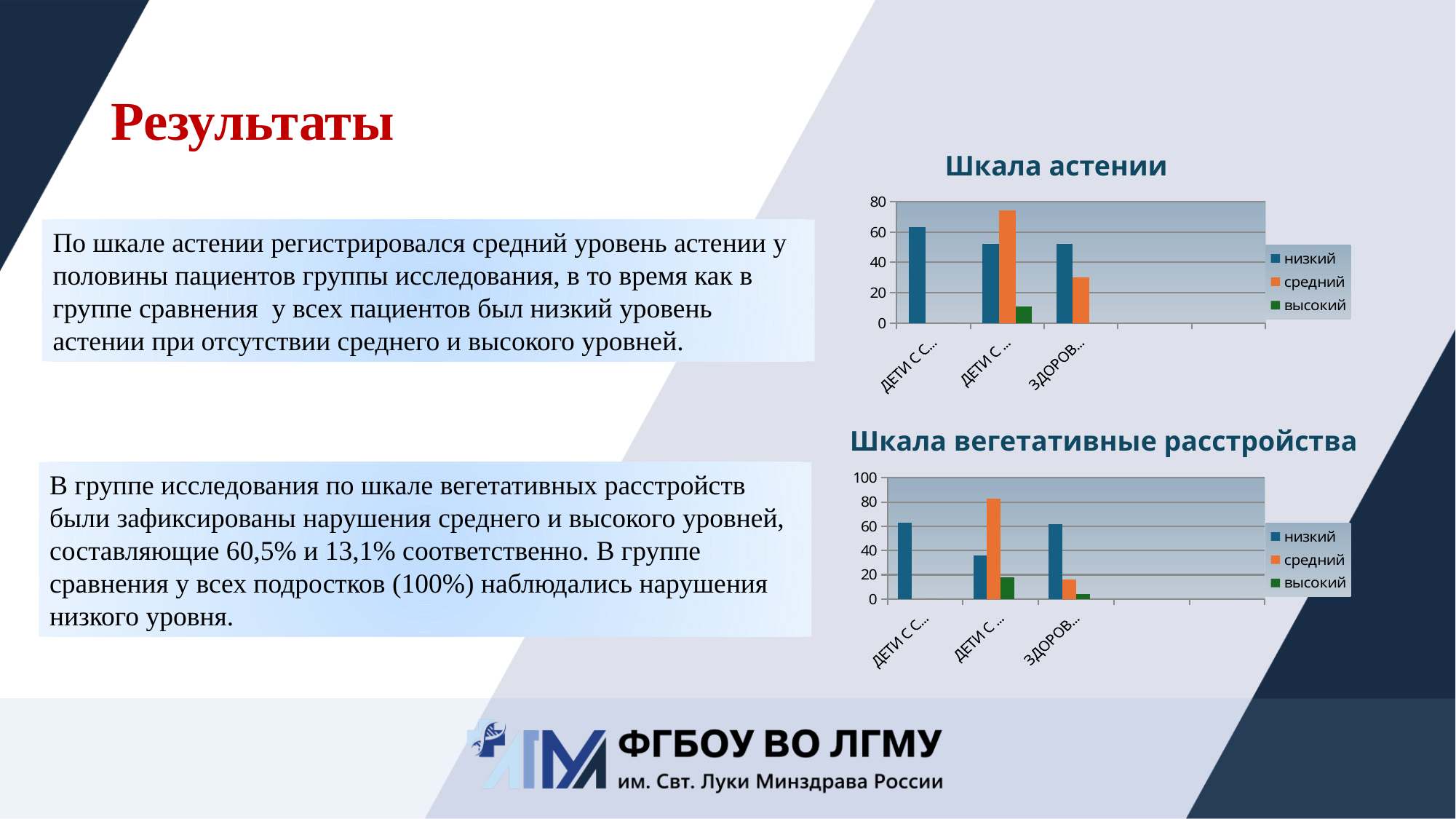
In the "Шкала астении" chart, which is larger for the third category group: the "низкий" bar or the "средний" bar? низкий In the "Шкала вегетативные расстройства" chart, is the "средний" value for the second category group greater or less than 60? greater In the "Шкала вегетативные расстройства" chart, which series has the shortest bar in the third category group? высокий What is the title of the lower chart on the slide? Шкала вегетативные расстройства In the "Шкала астении" chart, which series has the tallest bar in the second category group? средний How many series does the legend of the "Шкала вегетативные расстройства" chart list? 3 What kind of chart is the "Шкала астении" chart? bar chart What are the legend entries of the "Шкала астении" chart? низкий, средний, высокий In the "Шкала астении" chart, is the "средний" value for the second category group greater or less than 60? greater In the "Шкала вегетативные расстройства" chart, which series has the tallest bar in the second category group? средний How many category groups are shown on the x axis of the "Шкала вегетативные расстройства" chart? 3 In the "Шкала астении" chart, is the "высокий" value for the second category group greater or less than 20? less